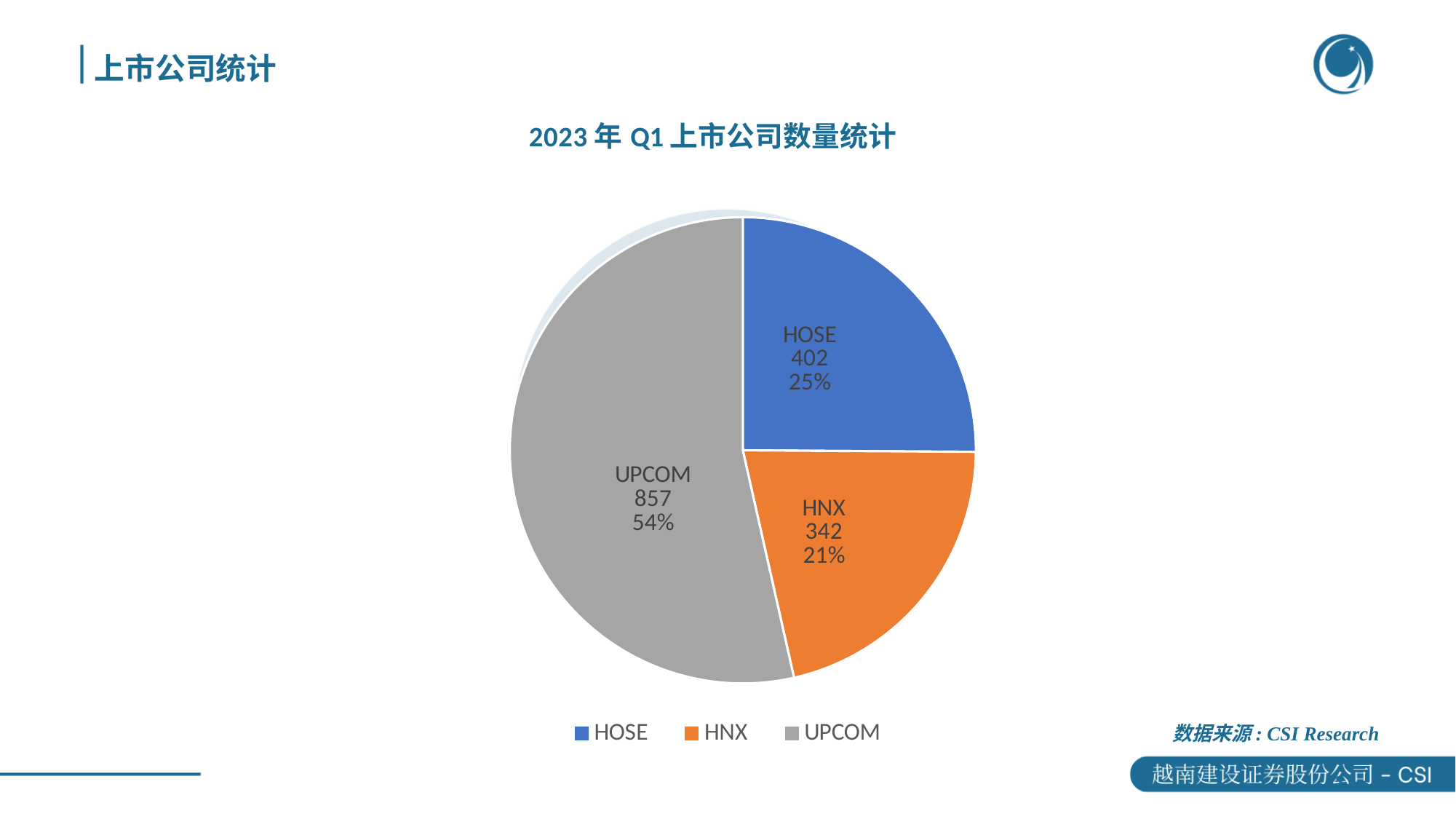
Which exchange has the largest number of listed companies? UPCOM What is the title of the chart? 2023 年 Q1 上市公司数量统计 How many slices does the pie chart have? 3 What type of chart is shown on the slide? pie chart What share of the pie does HNX represent? 21% How many listed companies does HOSE have according to the chart? 402 How many listed companies does UPCOM have according to the chart? 857 Which exchange has the smallest number of listed companies? HNX What is the difference between the number of listed companies on UPCOM and on HOSE? 455 What share of the pie does UPCOM represent? 54% Which has more listed companies, HOSE or HNX? HOSE How many listed companies does HNX have according to the chart? 342